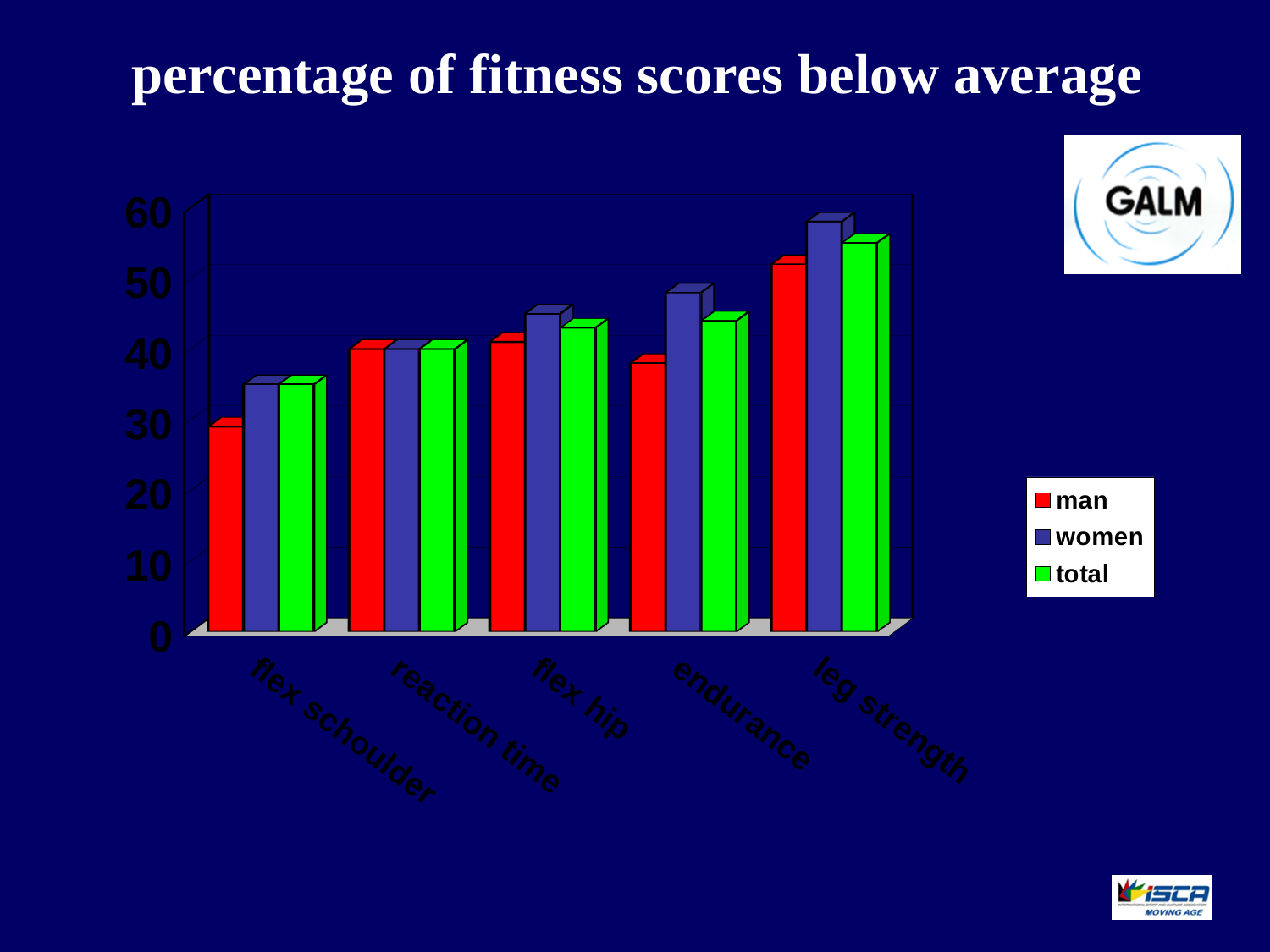
Is the value for women in leg strength greater or less than 50? greater Which category has the highest value for the women series? leg strength What is the title of the chart on the slide? percentage of fitness scores below average Which category has the lowest value for the man series? flex schoulder Is the value for women in endurance greater or less than 40? greater Which is larger in the endurance category: the value for man or the value for women? women Do the values for the women series rise or fall from flex schoulder to leg strength along the x axis? rise How many series does the chart's legend list? 3 What kind of chart is shown on the slide? bar chart Which colour represents the total series in the chart's legend? green How many categories are shown on the x axis of the chart? 5